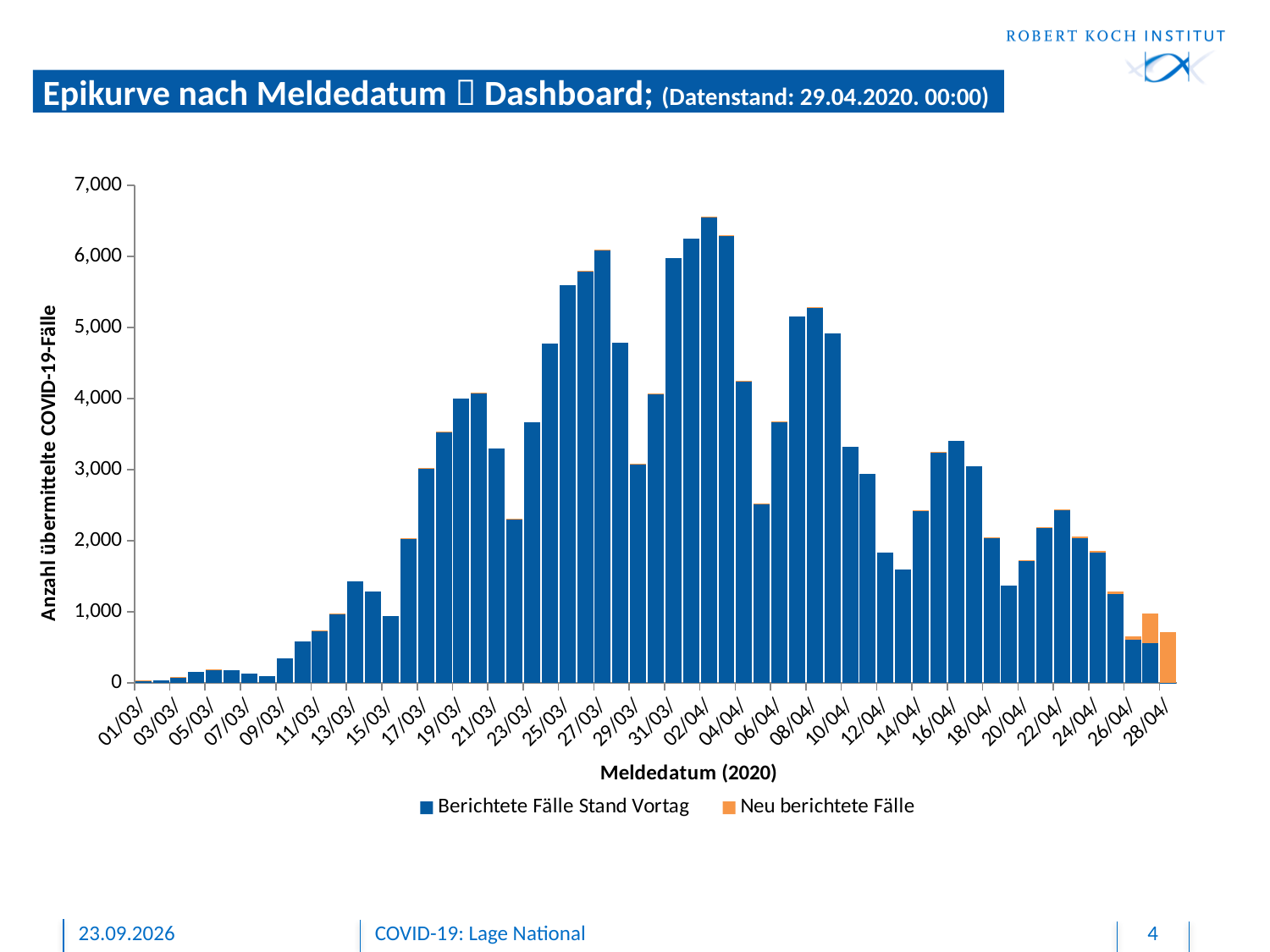
Is the value for 02/04 greater or less than 6,000? greater Is the value for 12/04 greater or less than 2,000? less What is the title of the y axis? Anzahl übermittelte COVID-19-Fälle Which date has the highest bar in the chart? 02/04 How many series does the legend list? 2 What kind of chart is shown on the slide? bar chart Which series is shown in orange according to the legend? Neu berichtete Fälle Is the value for 08/04 greater or less than 5,000? greater Which is larger, the bar for 25/03 or the bar for 12/04? 25/03 Do the bars generally rise or fall from 02/04 to 28/04? fall